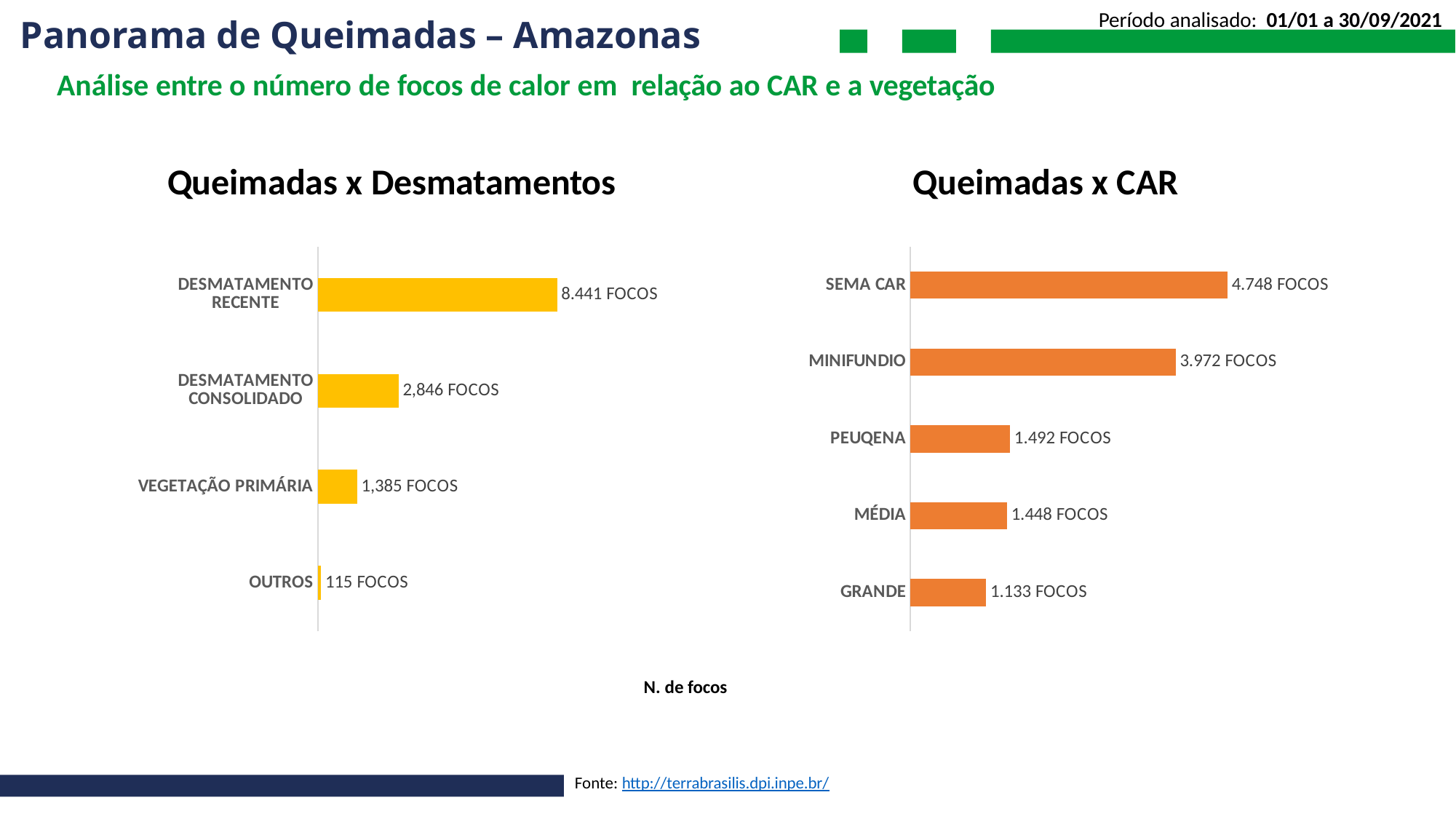
In the 'Queimadas x Desmatamentos' chart, which category has the highest number of focos? DESMATAMENTO RECENTE In the 'Queimadas x CAR' chart, what is the value for GRANDE? 1.133 FOCOS In the 'Queimadas x Desmatamentos' chart, what is the value for OUTROS? 115 FOCOS In the 'Queimadas x CAR' chart, what is the value for MINIFUNDIO? 3.972 FOCOS In the 'Queimadas x Desmatamentos' chart, which category has the lowest number of focos? OUTROS How many categories are plotted in the 'Queimadas x CAR' chart? 5 In the 'Queimadas x CAR' chart, what is the difference between SEMA CAR and MINIFUNDIO? 776 FOCOS What type of chart is the 'Queimadas x CAR' chart? Bar chart In the 'Queimadas x CAR' chart, which category has the highest number of focos? SEMA CAR How many categories are plotted in the 'Queimadas x Desmatamentos' chart? 4 In the 'Queimadas x Desmatamentos' chart, how many focos are shown for DESMATAMENTO RECENTE? 8.441 FOCOS In the 'Queimadas x CAR' chart, which is larger, PEUQENA or MÉDIA? PEUQENA